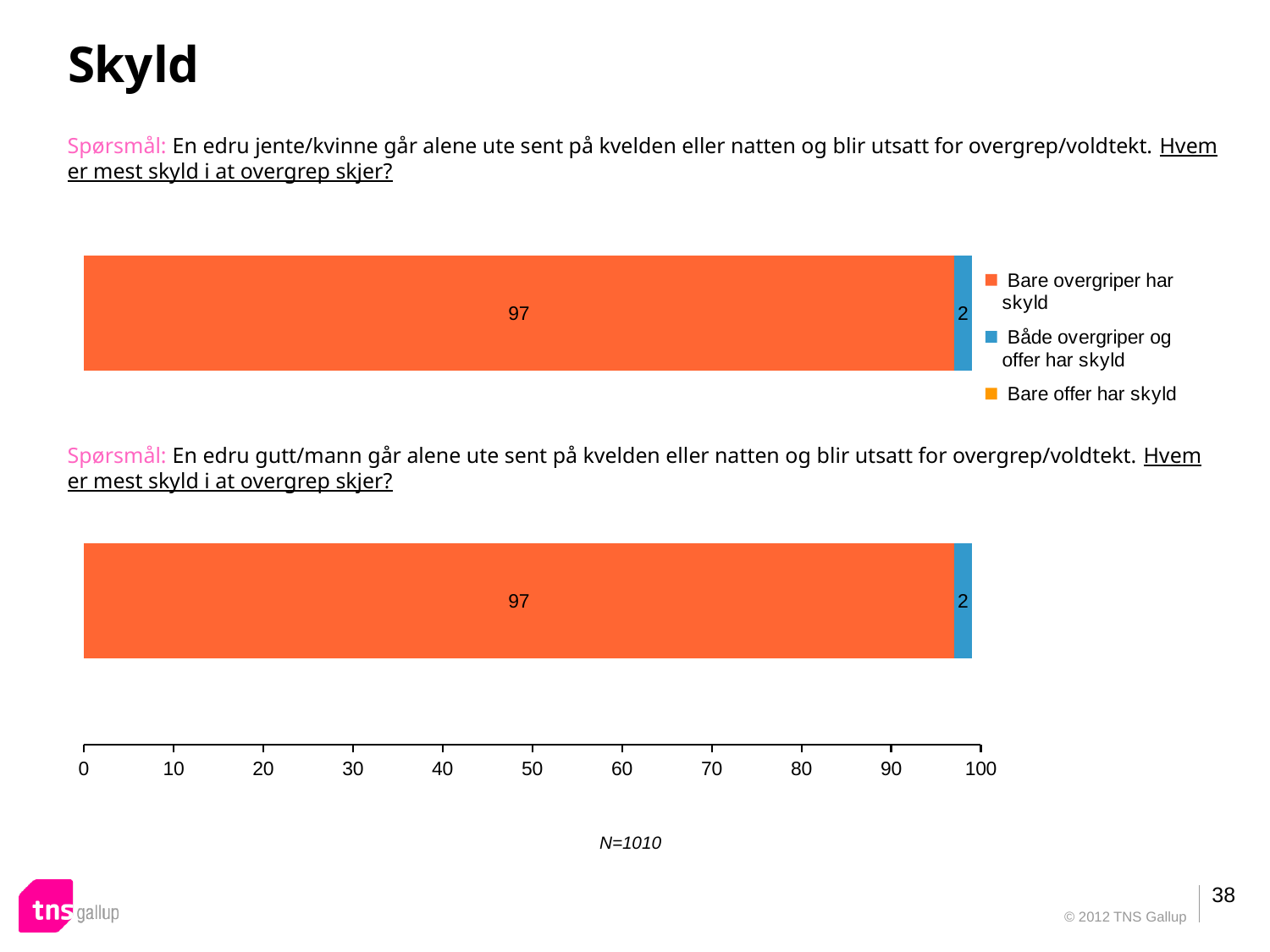
In the bottom chart, what is the difference between the values for 'Bare overgriper har skyld' and 'Både overgriper og offer har skyld'? 95 What is the total of the labelled segments in the top chart's bar? 99 How many series does the legend list? 3 In the top chart, which is larger: the value for 'Bare overgriper har skyld' or for 'Både overgriper og offer har skyld'? Bare overgriper har skyld What kind of chart is used on this slide? Stacked bar chart In the top chart, which category has the highest value? Bare overgriper har skyld What colour represents 'Bare overgriper har skyld' in the legend? Orange In the top chart (about a sober girl/woman), what value is shown for 'Både overgriper og offer har skyld'? 2 In the bottom chart (about a sober boy/man), what value is shown for 'Bare overgriper har skyld'? 97 In the bottom chart, is the value for 'Bare overgriper har skyld' greater or less than 90? greater In the top chart (about a sober girl/woman), what value is shown for 'Bare overgriper har skyld'? 97 In the bottom chart (about a sober boy/man), what value is shown for 'Både overgriper og offer har skyld'? 2